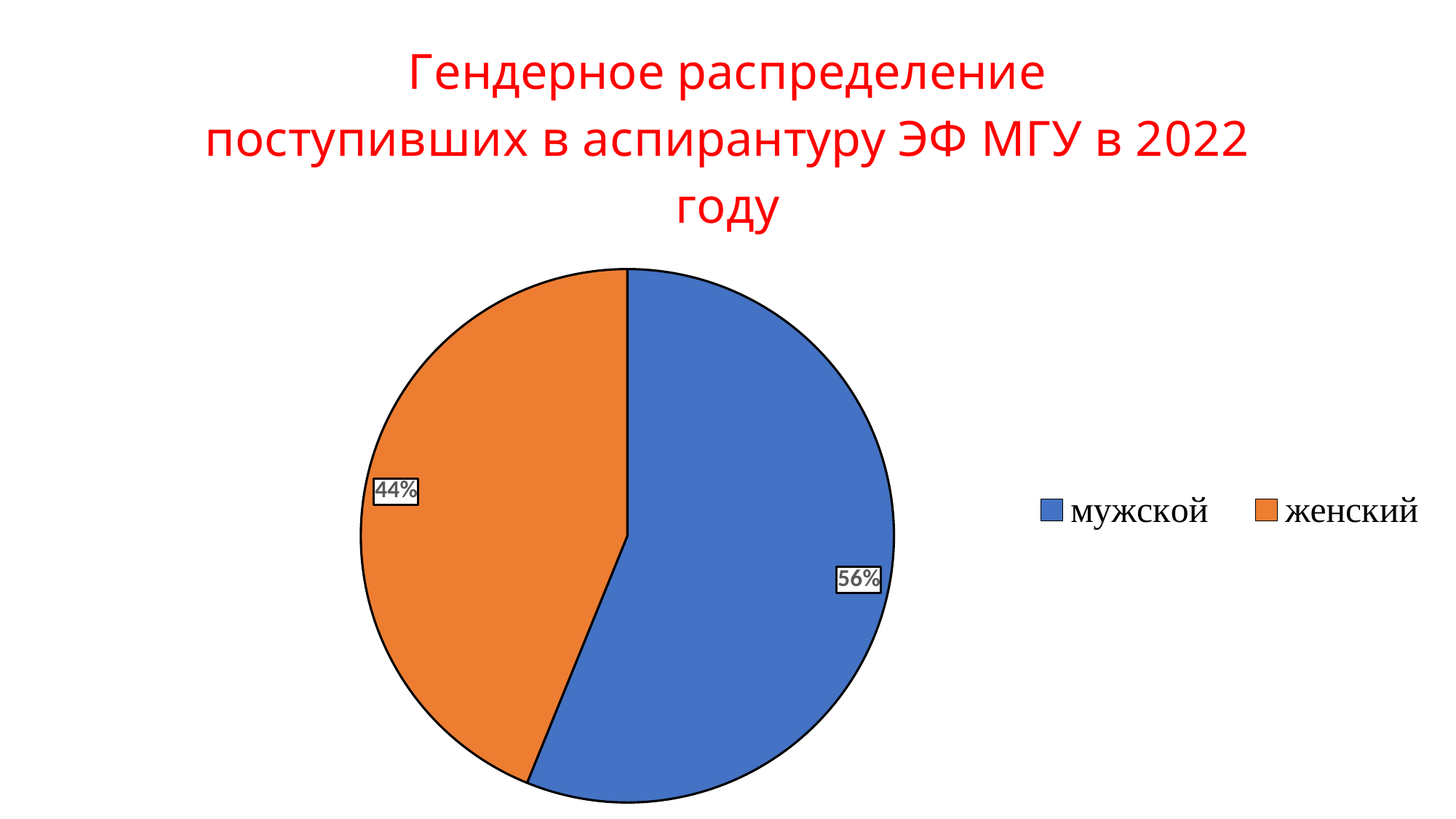
What share of the pie is labelled мужской? 56% Which category has the smallest slice of the pie? женский What kind of chart is shown on the slide? pie chart What share of the pie is labelled женский? 44% What colour is the женский slice? orange What is the difference in percentage points between the мужской and женский slices? 12% Which slice is larger, мужской or женский? мужской How many entries does the legend list? 2 How many slices does the pie chart have? 2 What is the title of the chart? Гендерное распределение поступивших в аспирантуру ЭФ МГУ в 2022 году Which category has the largest slice of the pie? мужской Is the share for мужской greater or less than 50%? greater